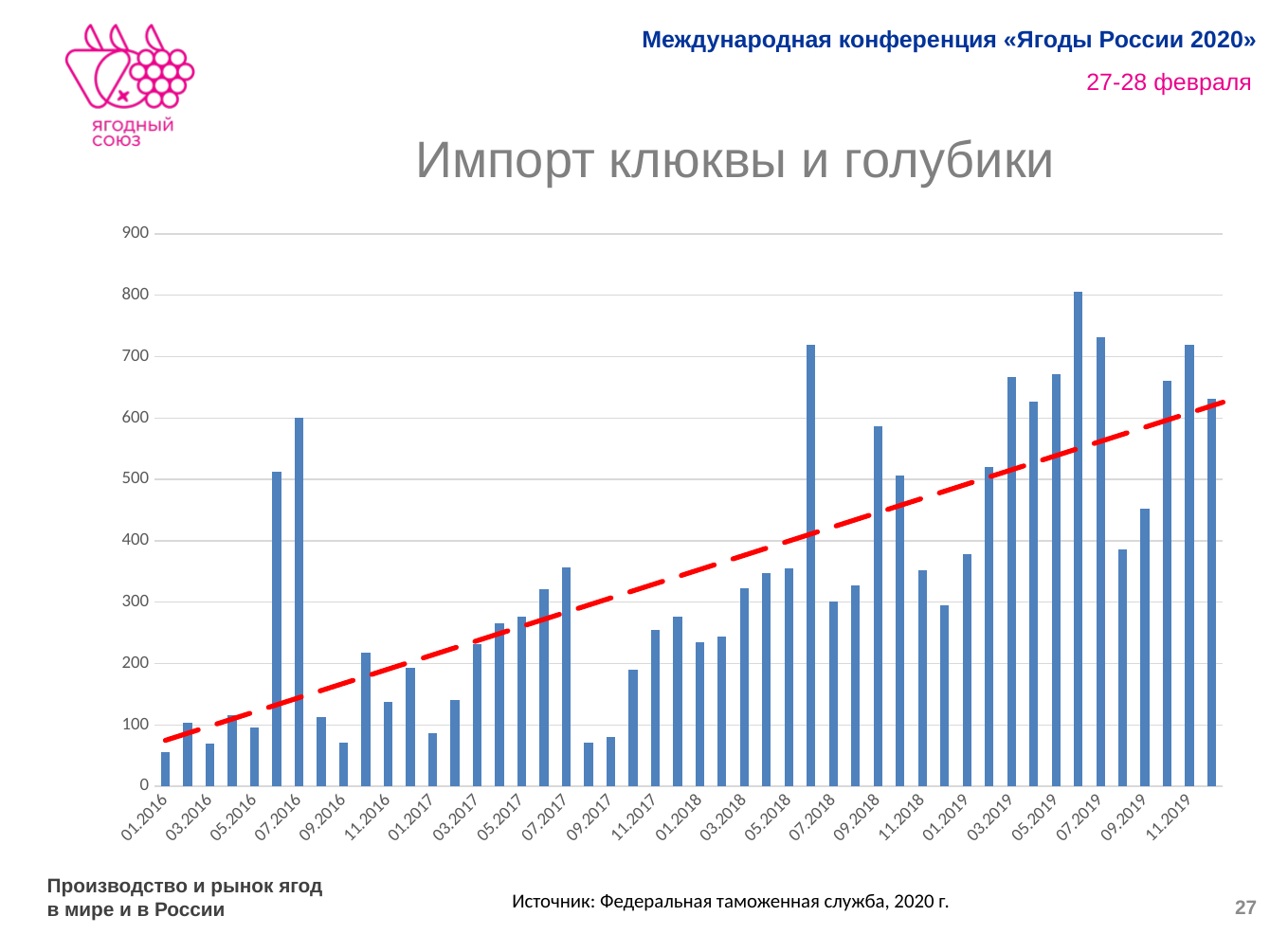
Which month has the highest bar on the chart? 06.2019 Is the value for 07.2018 greater or less than 600? less How many years does the x axis of the chart cover? 4 What kind of chart is shown on the slide? Bar chart What colour and style is the trend line drawn over the bars? Red dashed line Does the dashed trend line rise or fall from 01.2016 to the end of 2019? Rises Is the value for 07.2016 greater or less than 500? greater Is the value for 07.2019 greater or less than 700? greater Which is larger, the value for 07.2016 or the value for 07.2017? 07.2016 What is the title of the chart? Импорт клюквы и голубики Which month has the lowest bar on the chart? 01.2016